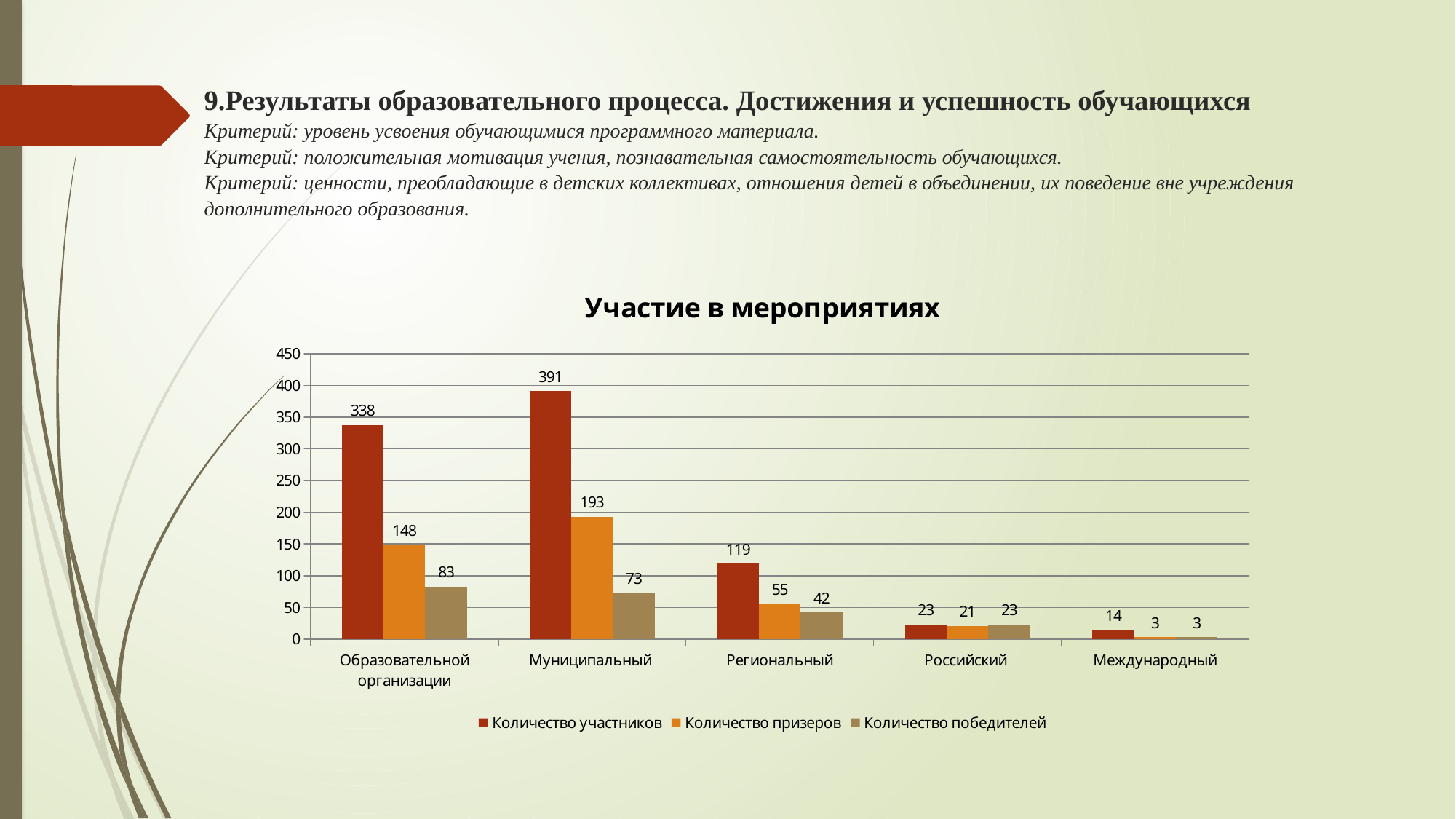
How many series does the legend list? 3 Which is larger: Количество победителей for Образовательной организации or for Муниципальный? Образовательной организации What is the value of Количество призеров for Образовательной организации? 148 Is the value of Количество участников for Региональный greater or less than 100? greater Which category has the highest value for Количество участников? Муниципальный Which category has the lowest value for Количество призеров? Международный What is the difference between Количество участников and Количество призеров for Муниципальный? 198 What kind of chart is shown on the slide? bar chart How many categories are shown on the x axis? 5 What is the title of the chart? Участие в мероприятиях What is the value of Количество победителей for Региональный? 42 What is the value of Количество участников for Муниципальный? 391